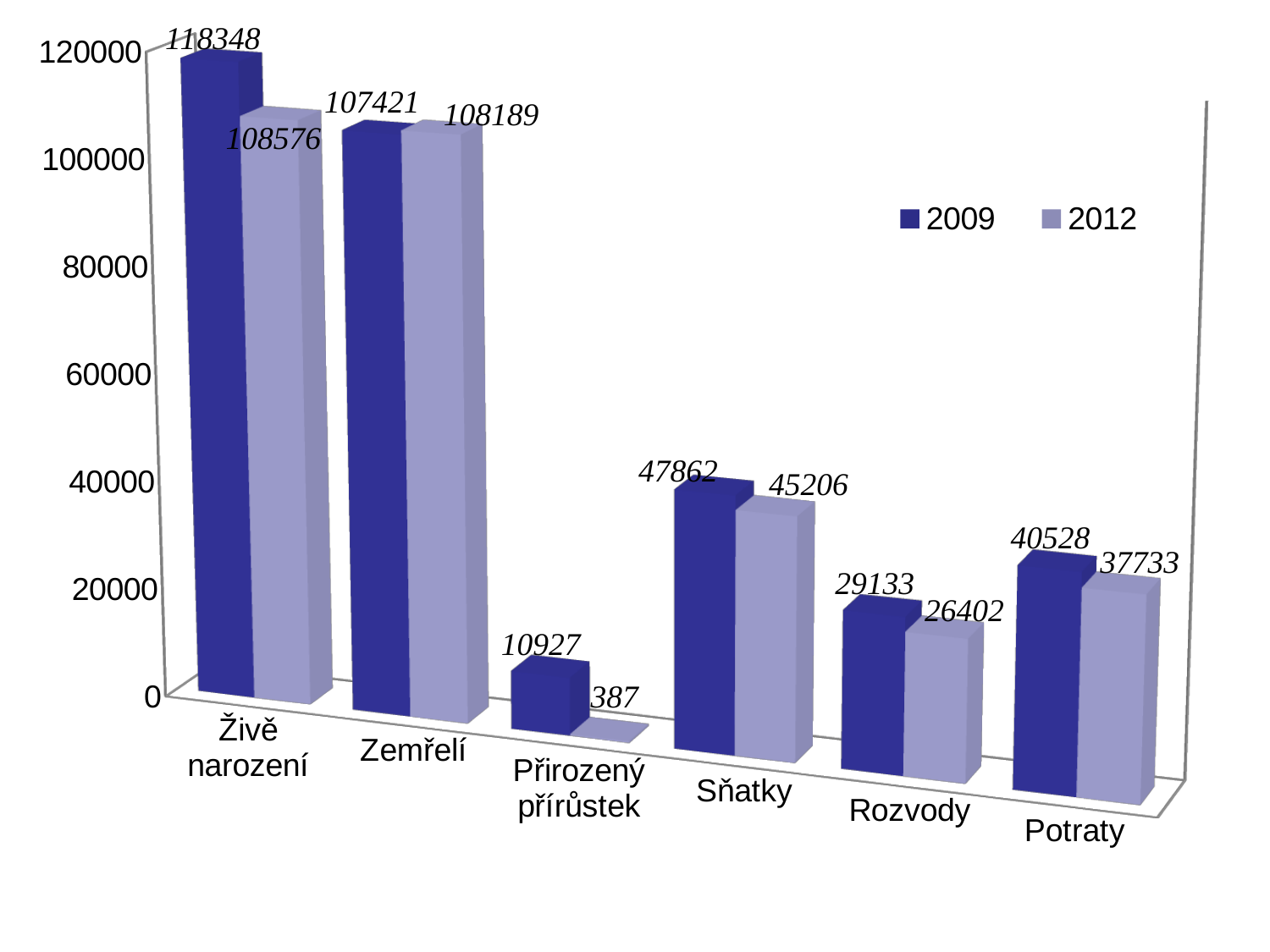
How many series does the legend list? 2 What is the value for Přirozený přírůstek in 2012? 387 Which is larger for Zemřelí: the 2009 value or the 2012 value? 2012 What kind of chart is shown on the slide? bar chart How many categories are shown on the x axis? 6 What is the value for Rozvody in 2009? 29133 What is the value for Zemřelí in 2012? 108189 Which category has the lowest value in the 2012 series? Přirozený přírůstek Which series is shown in the lighter colour according to the legend? 2012 What is the value for Živě narození in 2009? 118348 Which category has the highest value in the 2009 series? Živě narození What is the difference between the 2009 and 2012 values for Sňatky? 2656